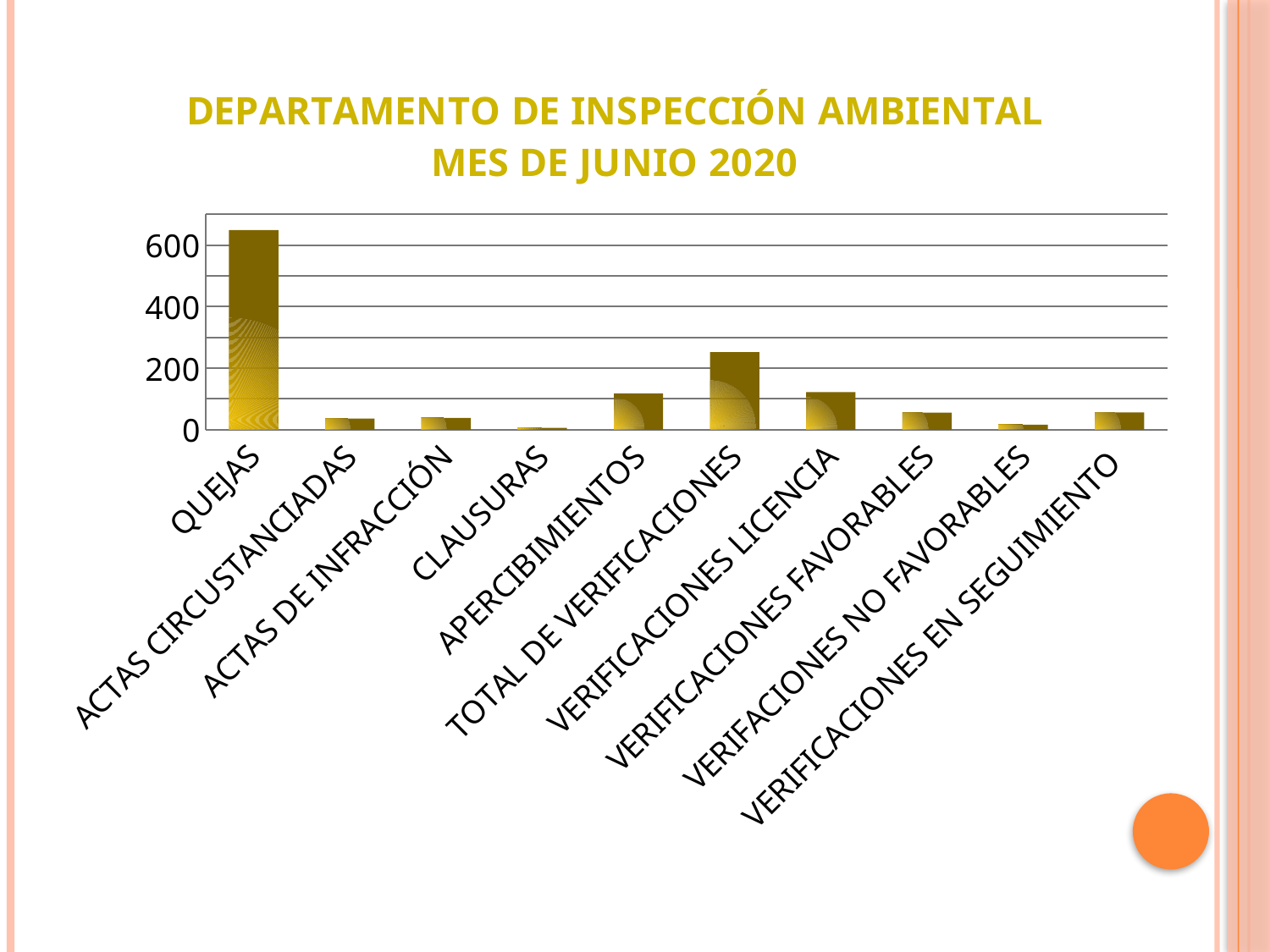
What kind of chart is shown on the slide? bar chart How many categories are plotted on the chart? 10 Is the value for TOTAL DE VERIFICACIONES greater or less than 200? greater Which is larger, the value for QUEJAS or the value for TOTAL DE VERIFICACIONES? QUEJAS Which is larger, the value for APERCIBIMIENTOS or the value for CLAUSURAS? APERCIBIMIENTOS Which category has the highest value? QUEJAS Is the value for QUEJAS greater or less than 600? greater Is the value for APERCIBIMIENTOS greater or less than 200? less Which is larger, the value for TOTAL DE VERIFICACIONES or the value for VERIFICACIONES LICENCIA? TOTAL DE VERIFICACIONES Which category has the lowest value? CLAUSURAS What month and year does the chart title refer to? JUNIO 2020